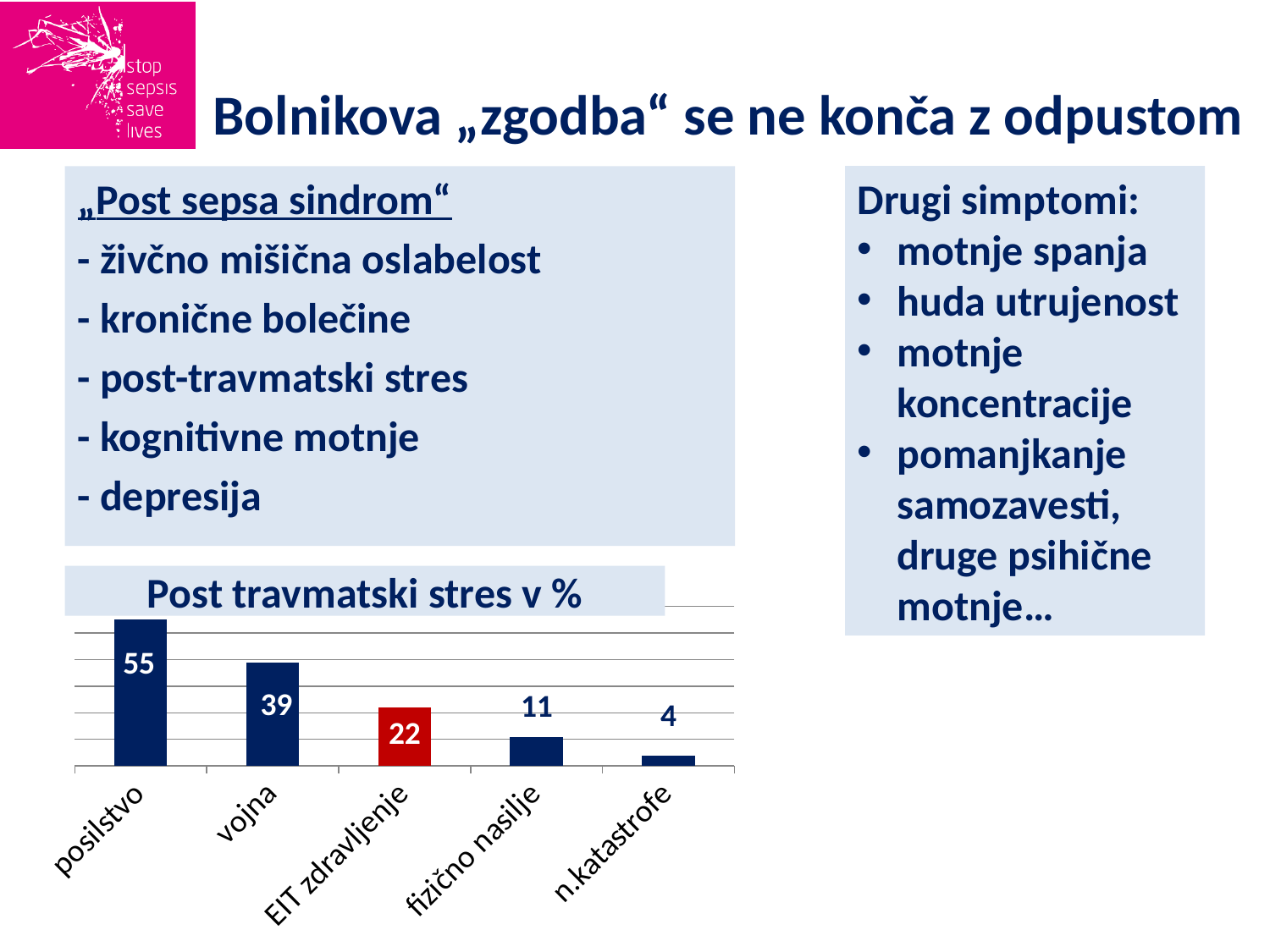
What is the value for n.katastrofe? 4 Do the values rise or fall from left to right along the x axis? fall Which is larger, the value for vojna or the value for EIT zdravljenje? vojna What is the value for posilstvo? 55 What kind of chart is shown on the slide? bar chart What is the difference between the values for EIT zdravljenje and fizično nasilje? 11 Which category has the highest value? posilstvo Which category has the lowest value? n.katastrofe What is the value for EIT zdravljenje? 22 What is the title of the chart? Post travmatski stres v % How many categories are shown in the chart? 5 What is the difference between the values for posilstvo and vojna? 16